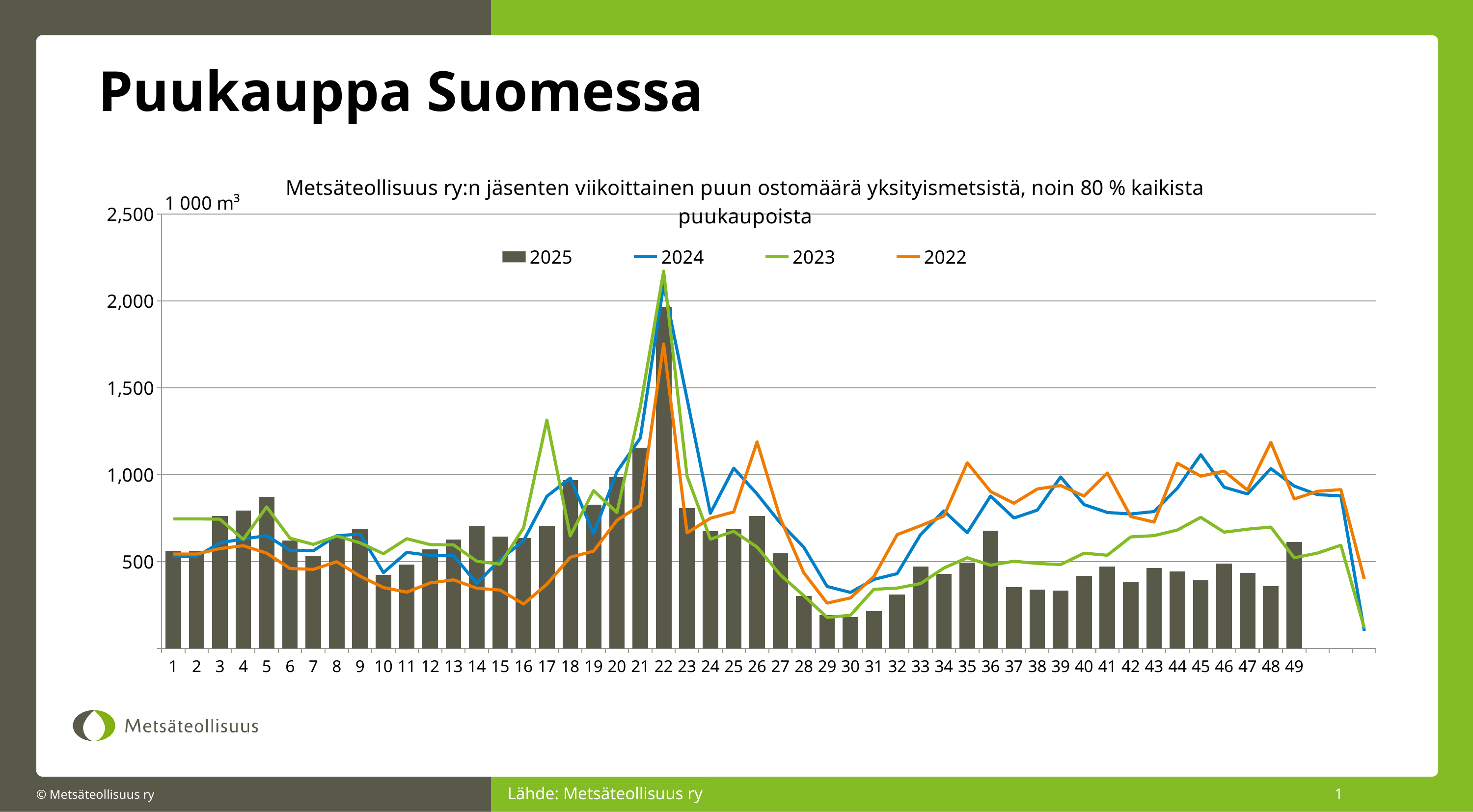
In which week is the 2025 bar highest? Week 22 Is the 2025 value for week 22 greater or less than 1,000? greater Is the 2023 value for week 22 greater or less than 2,000? greater Is the 2022 value for week 16 greater or less than 500? less What kind of chart is shown on the slide? A combined bar and line chart Which series is drawn as bars rather than a line? 2025 What unit is shown at the top of the vertical axis? 1 000 m³ Which is larger for 2025: the value for week 5 or the value for week 7? Week 5 Do the 2025 bars rise or fall from week 22 to week 29? Fall How many series does the chart legend list? 4